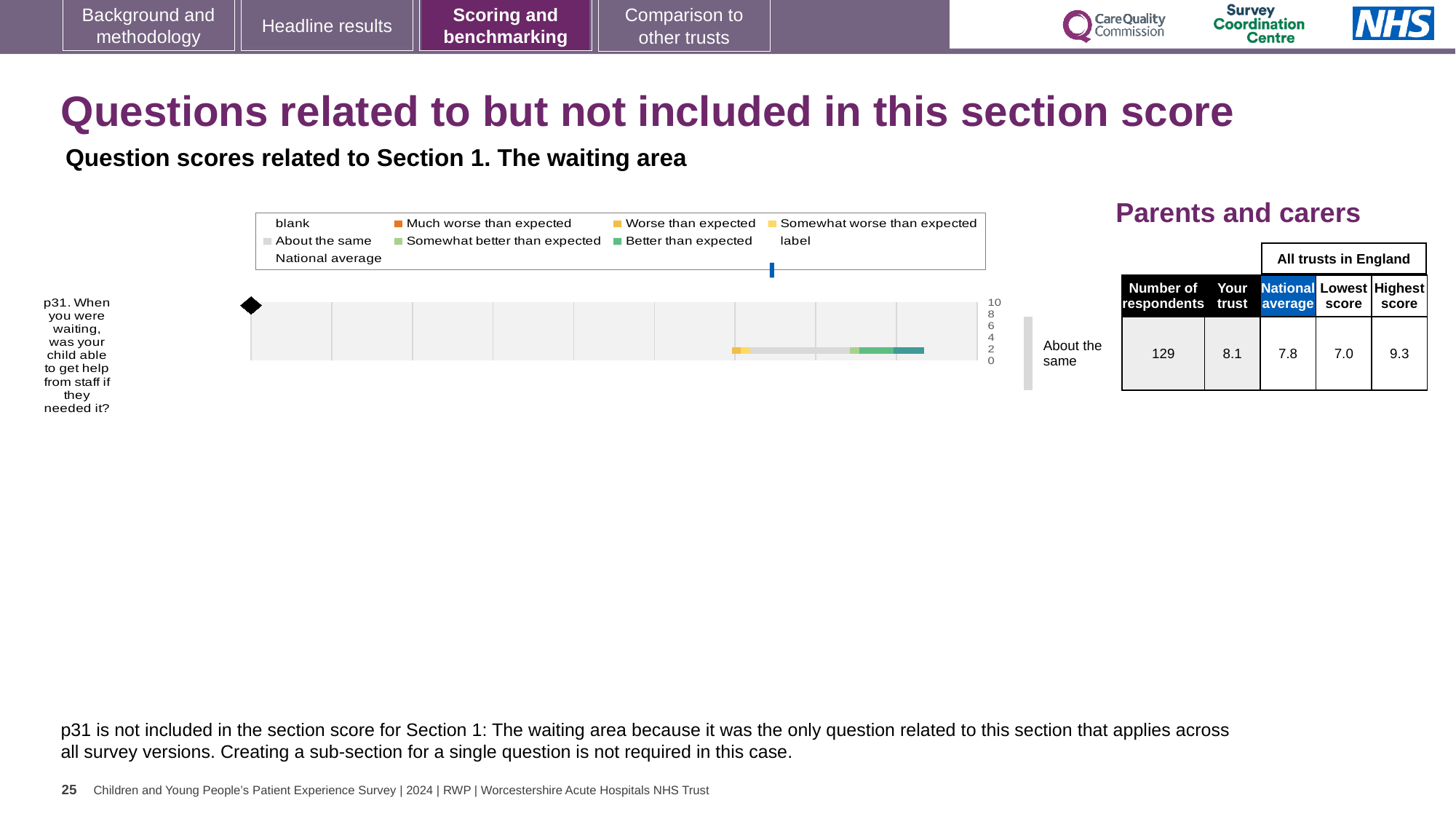
How many survey questions are plotted in the chart? 1 What is the National average score for p31? 7.8 What is the difference between the Highest score and the Lowest score for p31? 2.3 What kind of chart is used to show the p31 benchmarking result? Bar chart What category label is shown to the right of the p31 bar? About the same Which question is plotted in the chart? p31. When you were waiting, was your child able to get help from staff if they needed it? By how much does the Your trust score for p31 exceed the National average? 0.3 What is the 'Your trust' score for p31 in the Parents and carers table? 8.1 What is the Lowest score among all trusts in England for p31? 7.0 Which is higher for p31: the Your trust score or the National average? Your trust How many respondents answered p31? 129 What is the Highest score among all trusts in England for p31? 9.3